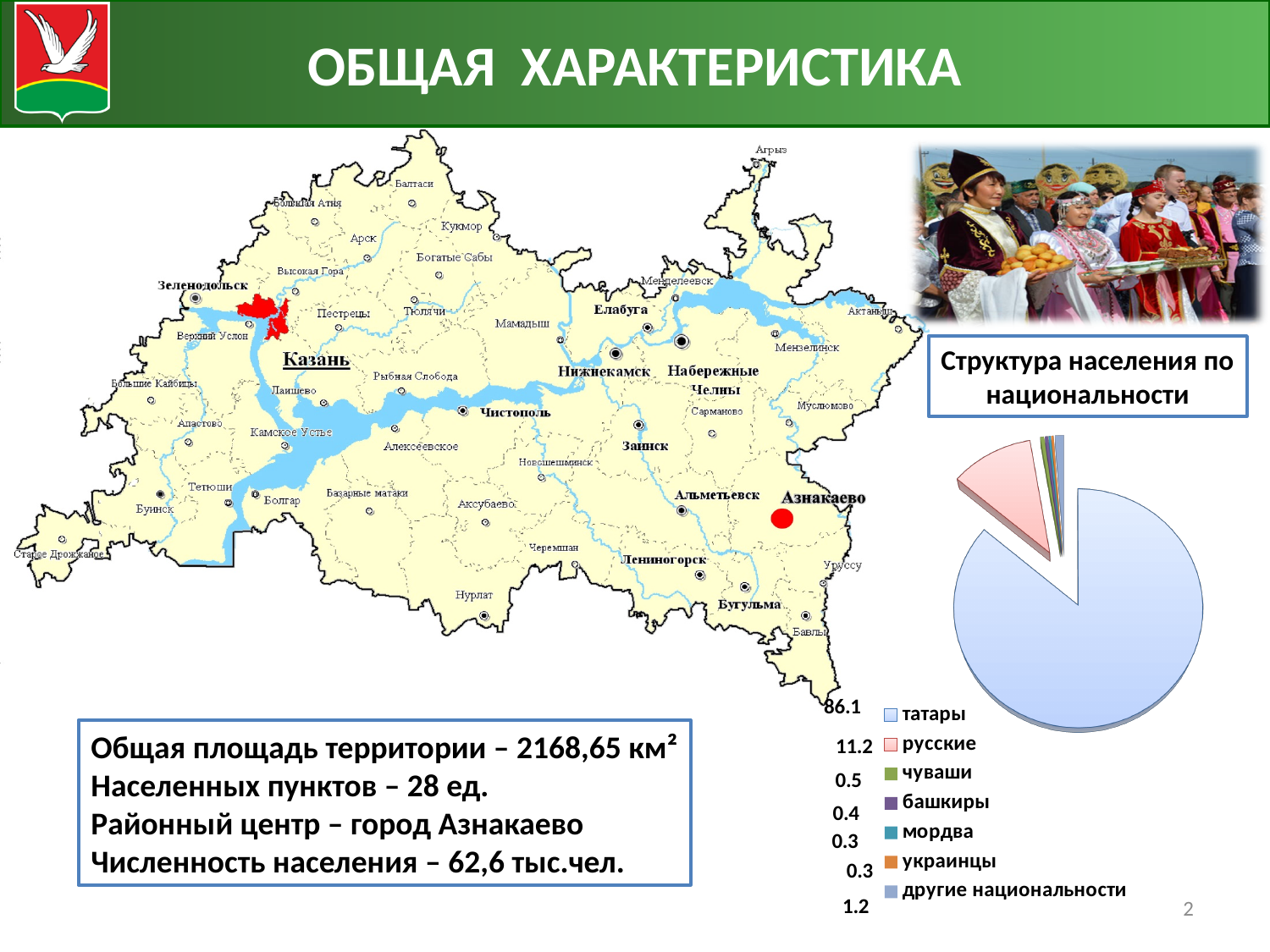
How many categories does the legend of the pie chart "Структура населения по национальности" list? 7 In the pie chart "Структура населения по национальности", what is the difference between the values for татары and русские? 74.9 In the pie chart "Структура населения по национальности", what is the value for русские? 11.2 In the pie chart "Структура населения по национальности", what is the value for башкиры? 0.4 In the pie chart "Структура населения по национальности", which category has the second largest share? русские In the pie chart "Структура населения по национальности", what is the value for другие национальности? 1.2 In the pie chart "Структура населения по национальности", which category has the largest share? татары What kind of chart is shown under the title "Структура населения по национальности"? pie chart What colour is the slice for русские in the pie chart "Структура населения по национальности"? pink In the pie chart "Структура населения по национальности", which is larger: the value for башкиры or the value for другие национальности? другие национальности In the pie chart "Структура населения по национальности", what is the value for чуваши? 0.5 In the pie chart "Структура населения по национальности", what is the value for татары? 86.1